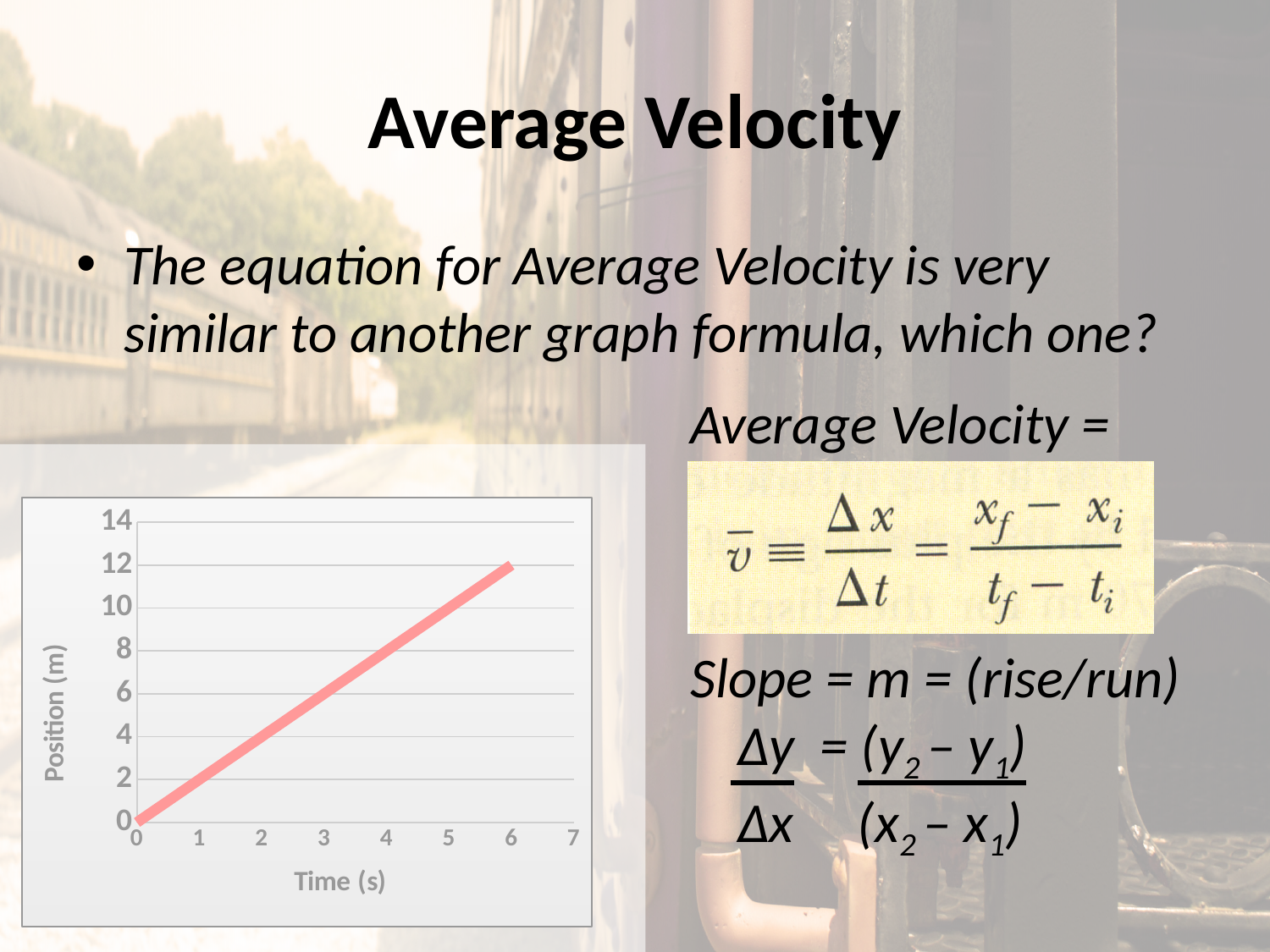
Is the position at time 4 s greater or less than 6? greater What is the label of the x axis of the chart? Time (s) Is the position at time 5 s greater or less than 8? greater Is the position at time 3 s greater or less than 8? less What kind of chart is shown on the slide? line chart What is the highest value shown on the y axis of the chart? 14 What is the label of the y axis of the chart? Position (m) Which is larger, the position at time 1 s or the position at time 5 s? time 5 s What is the position at time 6 s, where the line ends? 12 Does the position rise or fall as time increases along the x axis? rise What is the position at time 0 s, where the line starts? 0